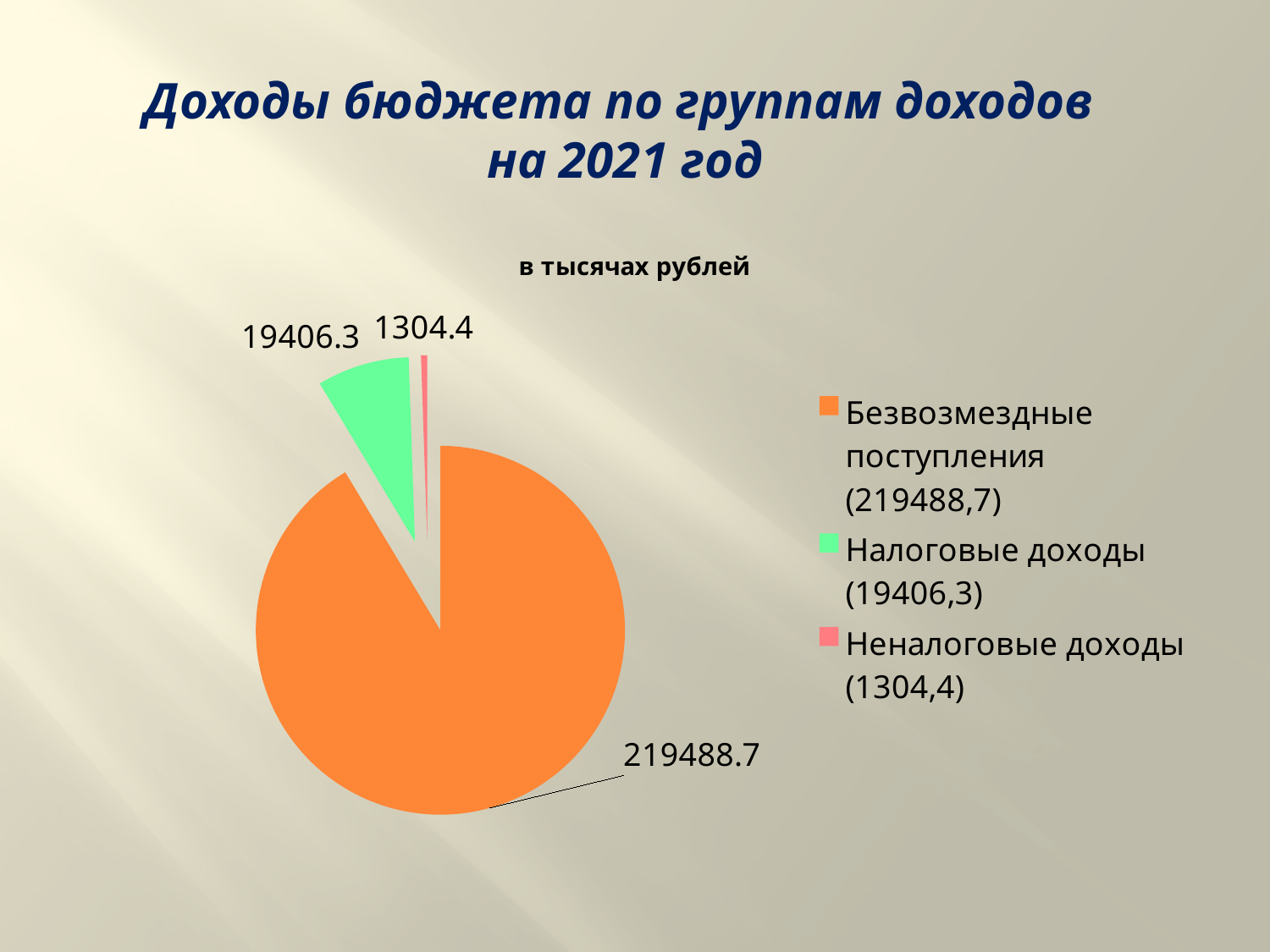
What is the difference between Налоговые доходы and Неналоговые доходы? 18101.9 Which income group has the largest slice of the pie? Безвозмездные поступления What is the difference between Безвозмездные поступления and Налоговые доходы? 200082.4 What type of chart is shown on the slide? pie chart What is the total of all three slices of the pie? 240199.4 What is the value for Неналоговые доходы? 1304.4 What unit is stated in the chart title above the pie? в тысячах рублей What is the value for Налоговые доходы? 19406.3 What is the value for Безвозмездные поступления? 219488.7 Which is larger, Налоговые доходы or Неналоговые доходы? Налоговые доходы How many slices does the pie chart have? 3 Which income group has the smallest slice of the pie? Неналоговые доходы